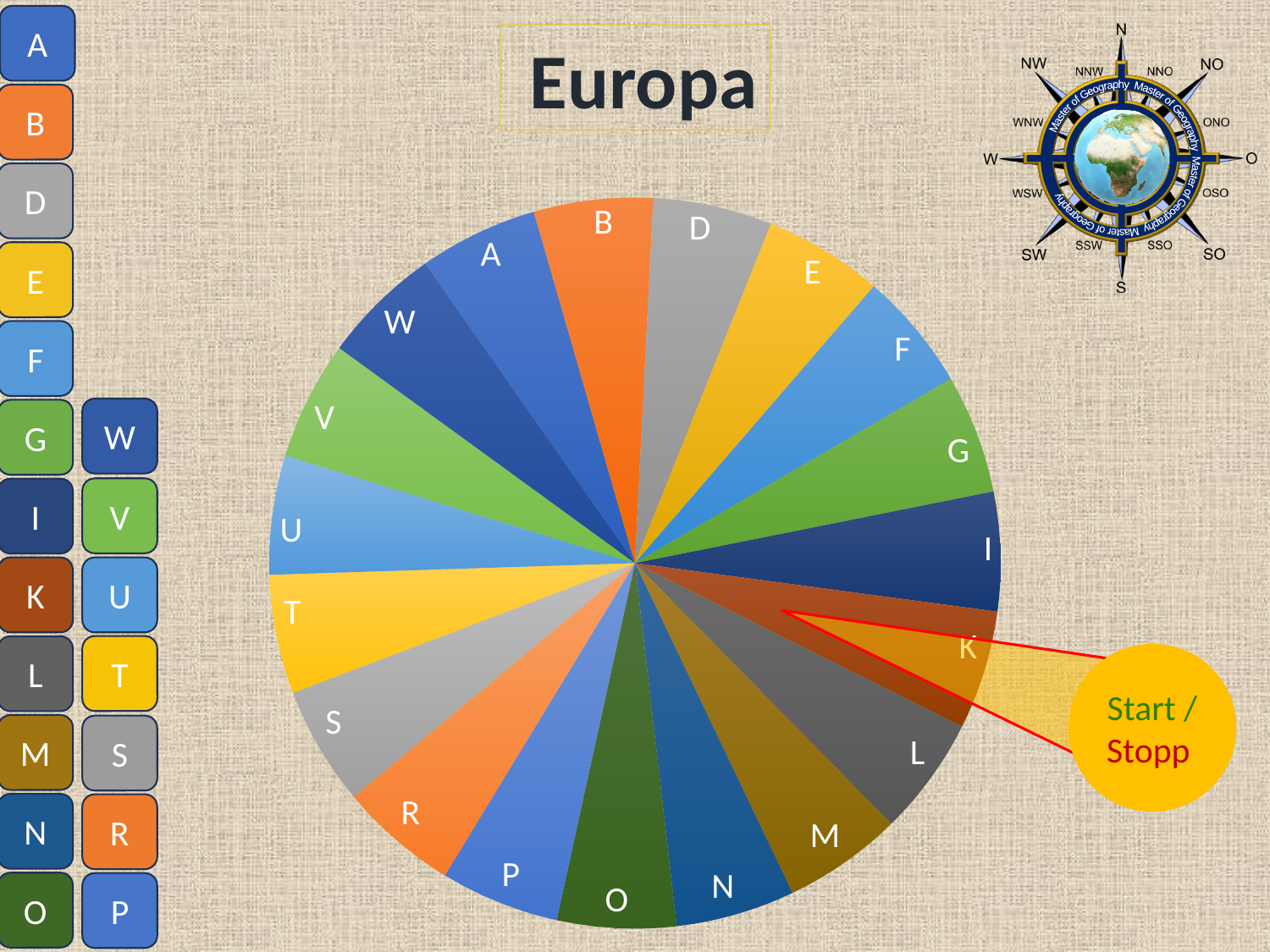
How many slices does the pie chart have? 19 Which slice label lies between the slices labelled R and T? S Which slice label lies between the slices labelled V and A? W What kind of chart is shown on the slide? pie chart Which slice label lies between the slices labelled L and N? M Which slice label lies between the slices labelled G and K? I Which slice label lies between the slices labelled T and V? U What is the title shown above the pie chart? Europa Which slice label lies between the slices labelled B and E? D Which slice label lies between the slices labelled N and P? O Which letter labels the orange slice at the top of the pie chart, between A and D? B